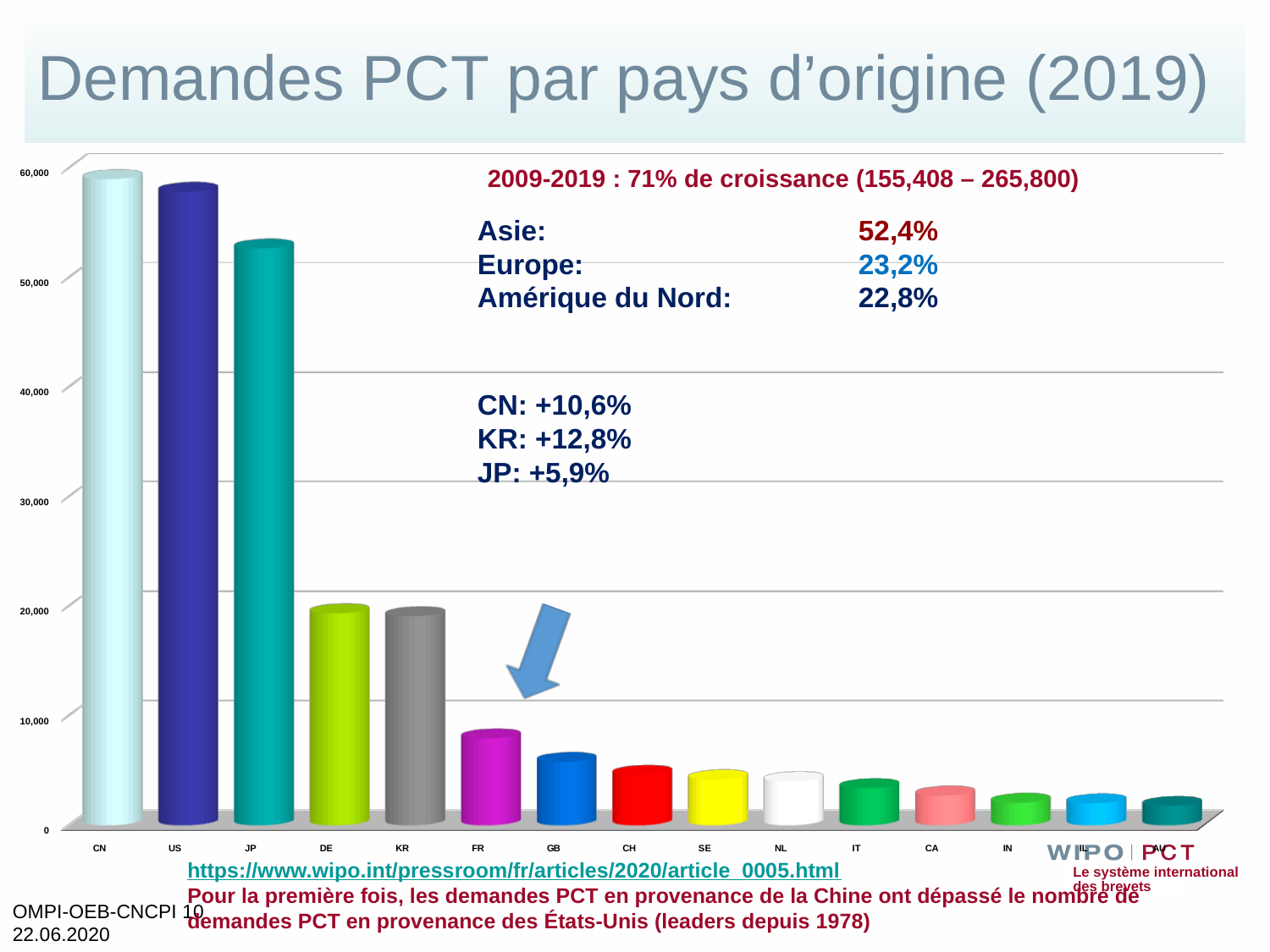
Is the value for JP greater or less than 50,000? greater Is the value for DE greater or less than 10,000? greater Do the bar values rise or fall from left to right along the x axis? fall Is the value for FR greater or less than 10,000? less What kind of chart is shown on the slide? bar chart How many country bars are plotted in the chart? 15 Which is larger, the value for JP or the value for DE? JP What is the title of the slide containing the chart? Demandes PCT par pays d'origine (2019) Which country has the highest bar in the chart? CN Which is larger, the value for DE or the value for FR? DE